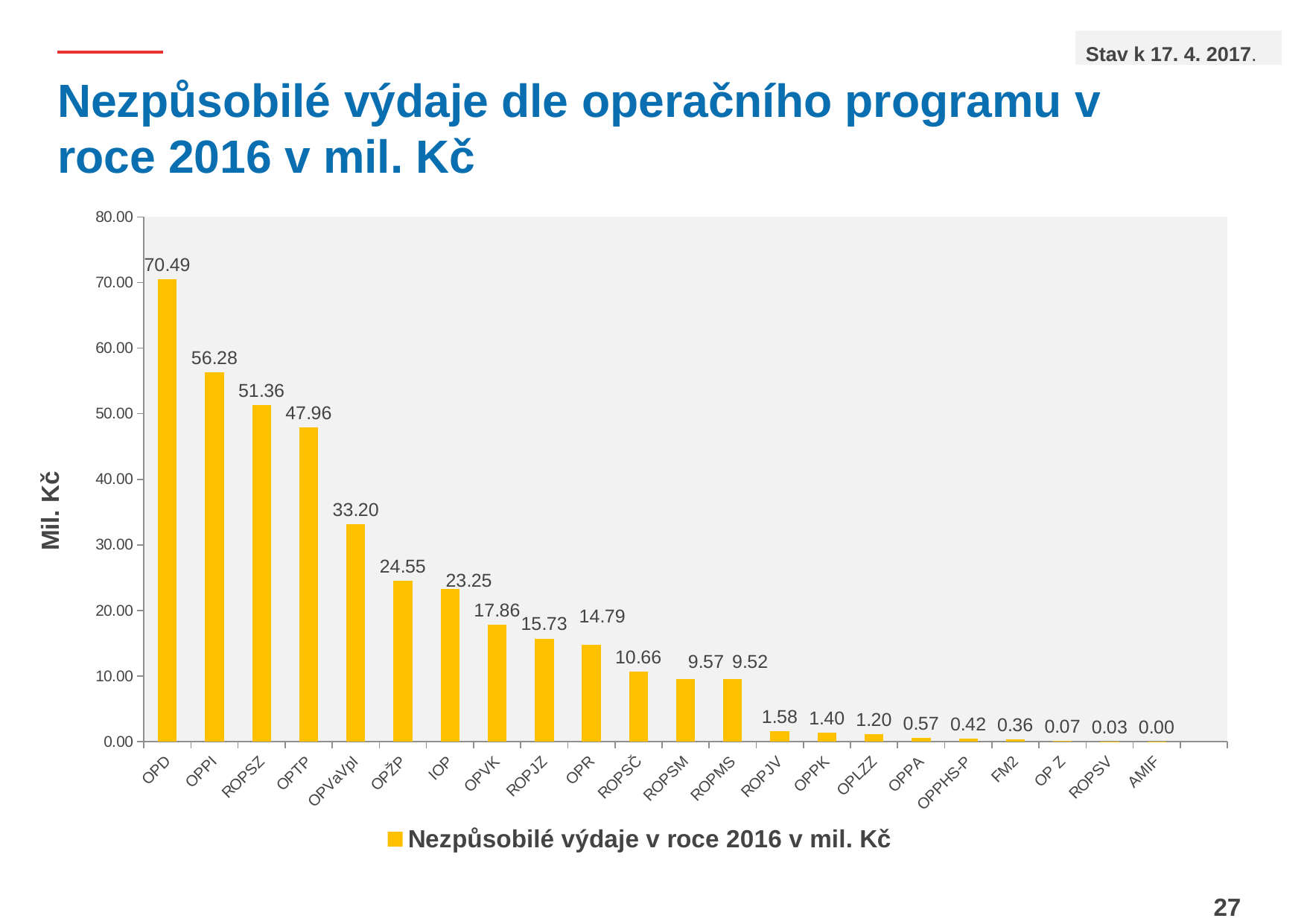
What is the difference between the values for OPVK and ROPJZ? 2.13 How many operational programmes are shown on the x axis? 22 What is the label on the y axis? Mil. Kč Which operational programme has the highest value? OPD Which is larger, the value for ROPSZ or the value for OPTP? ROPSZ What is the value for OPD? 70.49 What is the value for OPVaVpI? 33.20 Is the value for OPŽP greater or less than 20.00? greater What is the difference between the values for OPD and OPPI? 14.21 What kind of chart is shown on the slide? bar chart What is the value for ROPSČ? 10.66 Which operational programme has the lowest value? AMIF